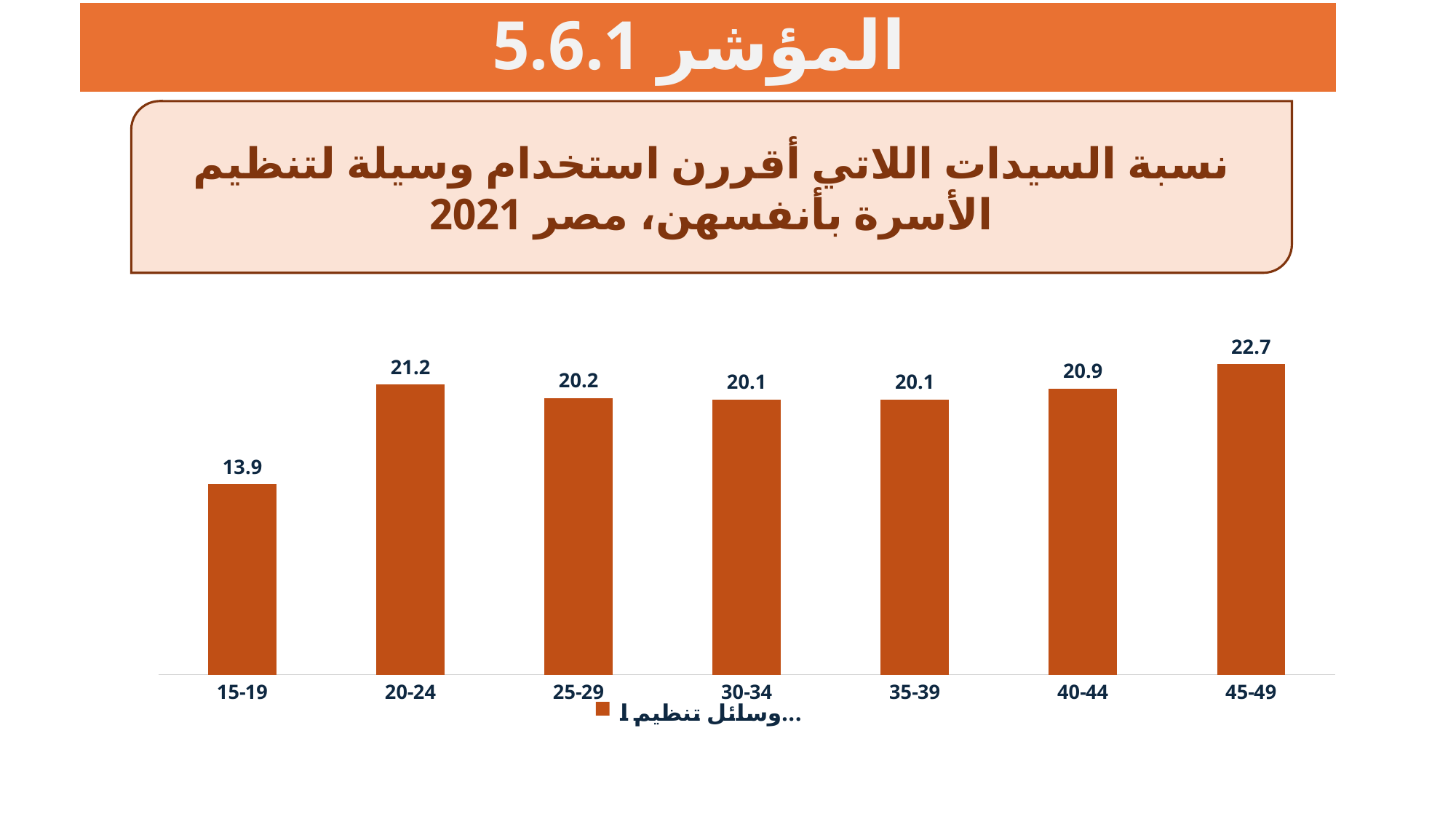
What is the difference between the values for 45-49 and 15-19? 8.8 What is the value for the 45-49 age group? 22.7 What is the value for the 15-19 age group? 13.9 Which age group has the lowest value? 15-19 What is the value for the 40-44 age group? 20.9 Which age group has the highest value? 45-49 What is the value for the 20-24 age group? 21.2 What is the difference between the values for 20-24 and 25-29? 1.0 How many age groups are shown on the chart? 7 What year is mentioned in the chart title? 2021 What kind of chart is shown on the slide? bar chart Which is larger, the value for 20-24 or the value for 40-44? 20-24